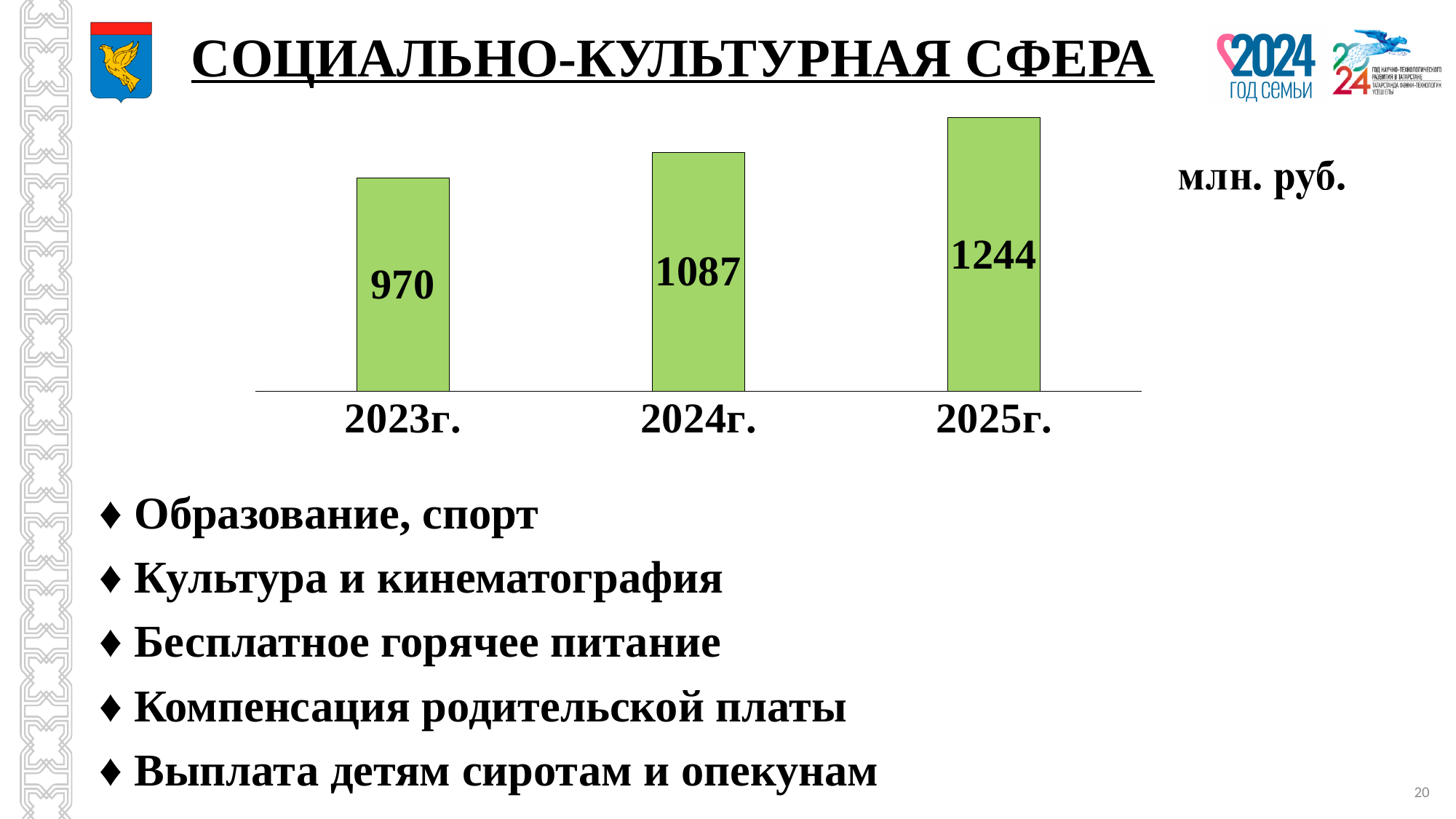
What is the difference between the values for 2024г. and 2023г.? 117 Which year has the lowest value? 2023г. What is the difference between the values for 2025г. and 2024г.? 157 What is the value for 2025г.? 1244 Which is larger, the value for 2023г. or the value for 2024г.? 2024г. Which year has the highest value? 2025г. Do the values rise or fall from 2023г. to 2025г.? rise What unit is indicated next to the chart? млн. руб. What kind of chart is shown on the slide? bar chart What is the value for 2024г.? 1087 What is the value for 2023г.? 970 How many bars are shown in the chart? 3